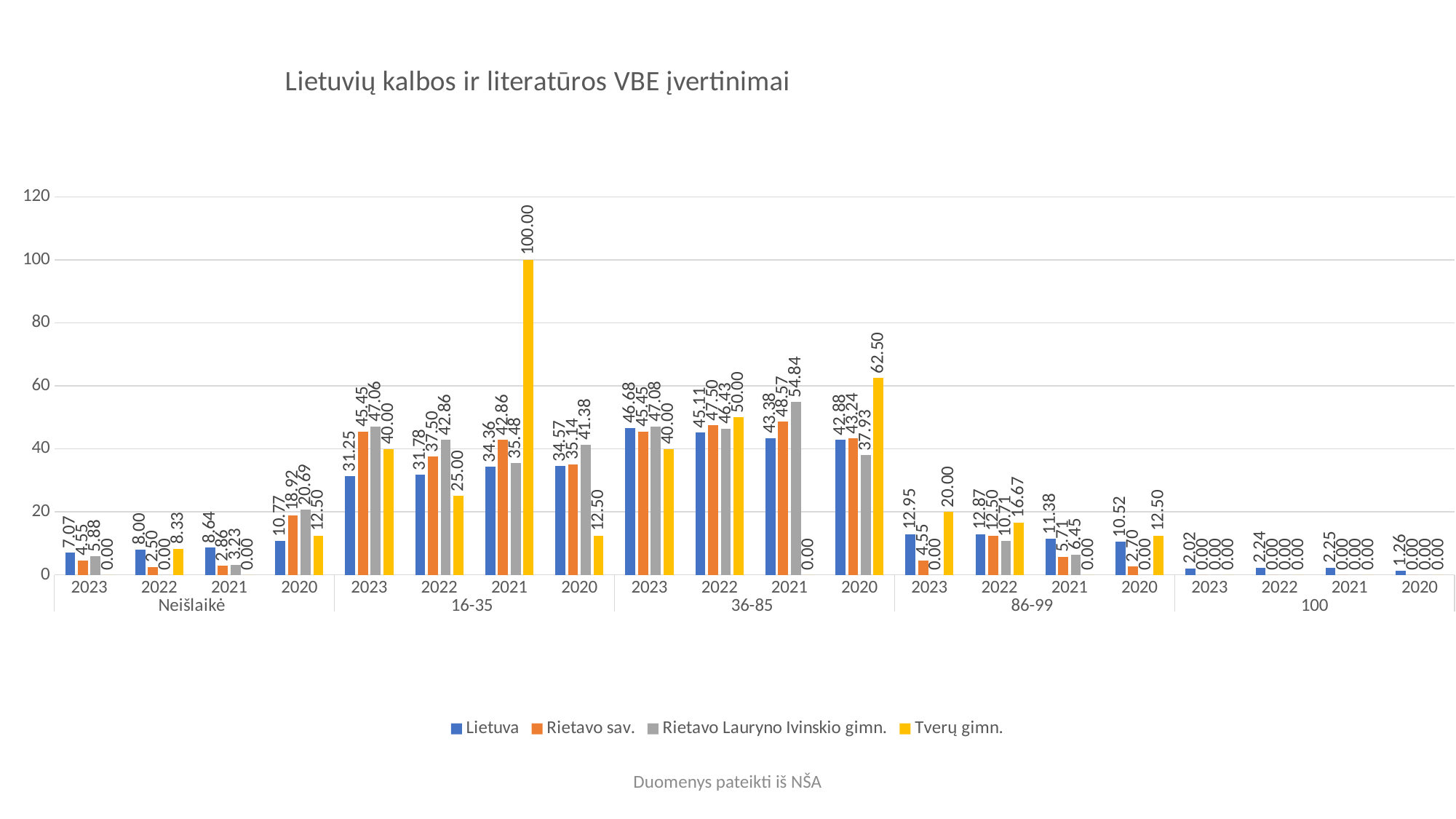
What is the value for Tverų gimn. in 2021 in the 16-35 group? 100.00 Which series has the highest value in 2020 in the 36-85 group? Tverų gimn. How does the Lietuva value change from 2023 to 2020 in the 86-99 group? It falls What kind of chart is shown? Bar chart What is the value for Rietavo Lauryno Ivinskio gimn. in 2021 in the 36-85 group? 54.84 How many series does the legend list? 4 What is the title of the chart? Lietuvių kalbos ir literatūros VBE įvertinimai Which series has the lowest value in 2023 in the 16-35 group? Lietuva What is the value for Rietavo sav. in 2020 in the 86-99 group? 2.70 Which is larger in 2020 in the Neišlaikė group: Rietavo sav. or Lietuva? Rietavo sav. What is the difference between the Tverų gimn. value and the Lietuva value in 2021 in the 16-35 group? 65.64 What is the value for Lietuva in 2023 in the Neišlaikė group? 7.07